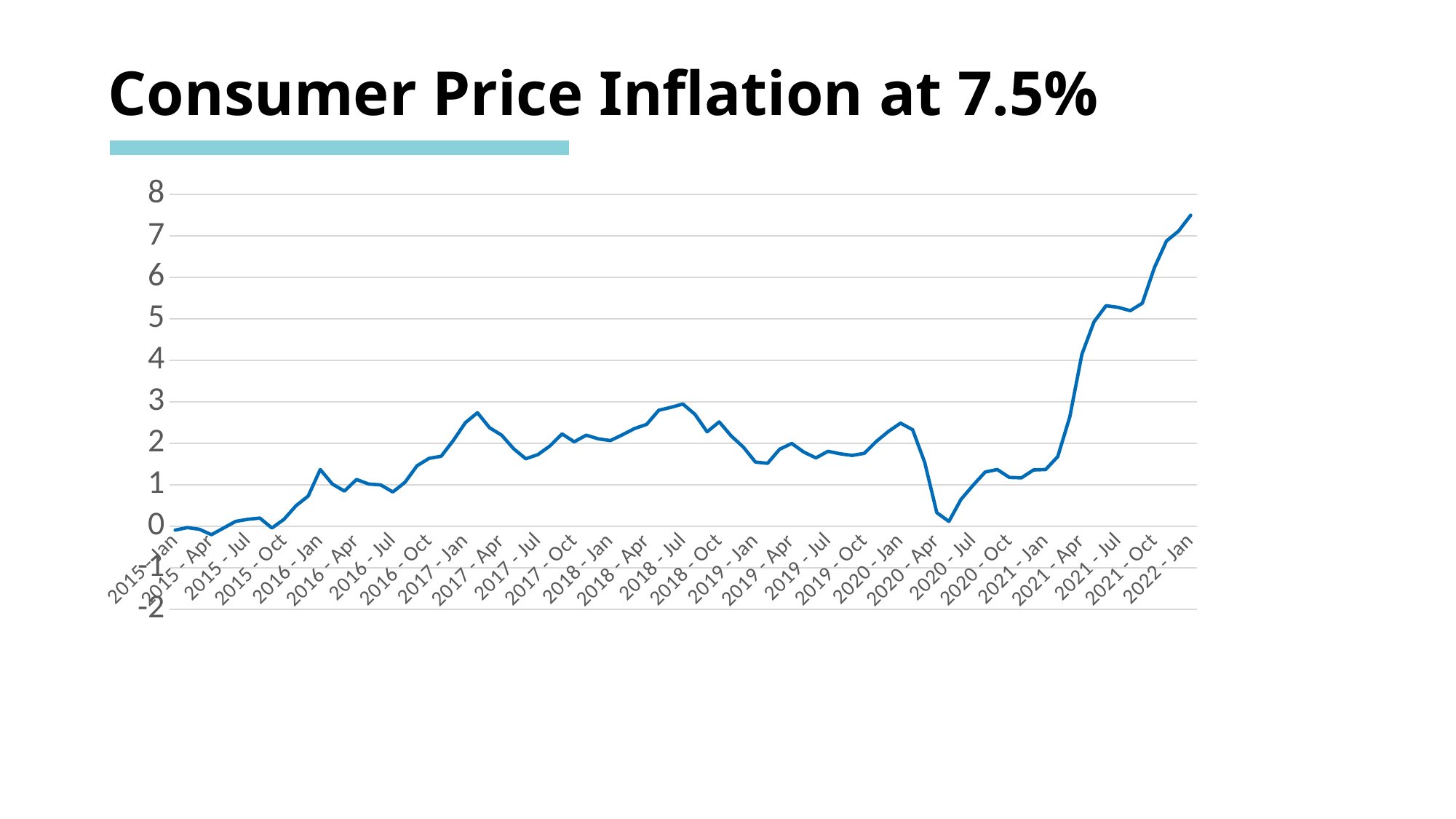
What is the title of the slide? Consumer Price Inflation at 7.5% Is the value for 2021 - Jul greater or less than 4? greater What kind of chart is shown on the slide? line chart Is the value for 2020 - Apr greater or less than 1? less Which is larger, the value for 2022 - Jan or the value for 2018 - Jul? 2022 - Jan Is the value for 2018 - Jul greater or less than 2? greater Overall, does the line rise or fall from 2021 - Jan to 2022 - Jan? rise Which is larger, the value for 2020 - Jan or the value for 2020 - Apr? 2020 - Jan Which x-axis label has the highest value on the line? 2022 - Jan According to the slide title, what is the current consumer price inflation rate? 7.5%